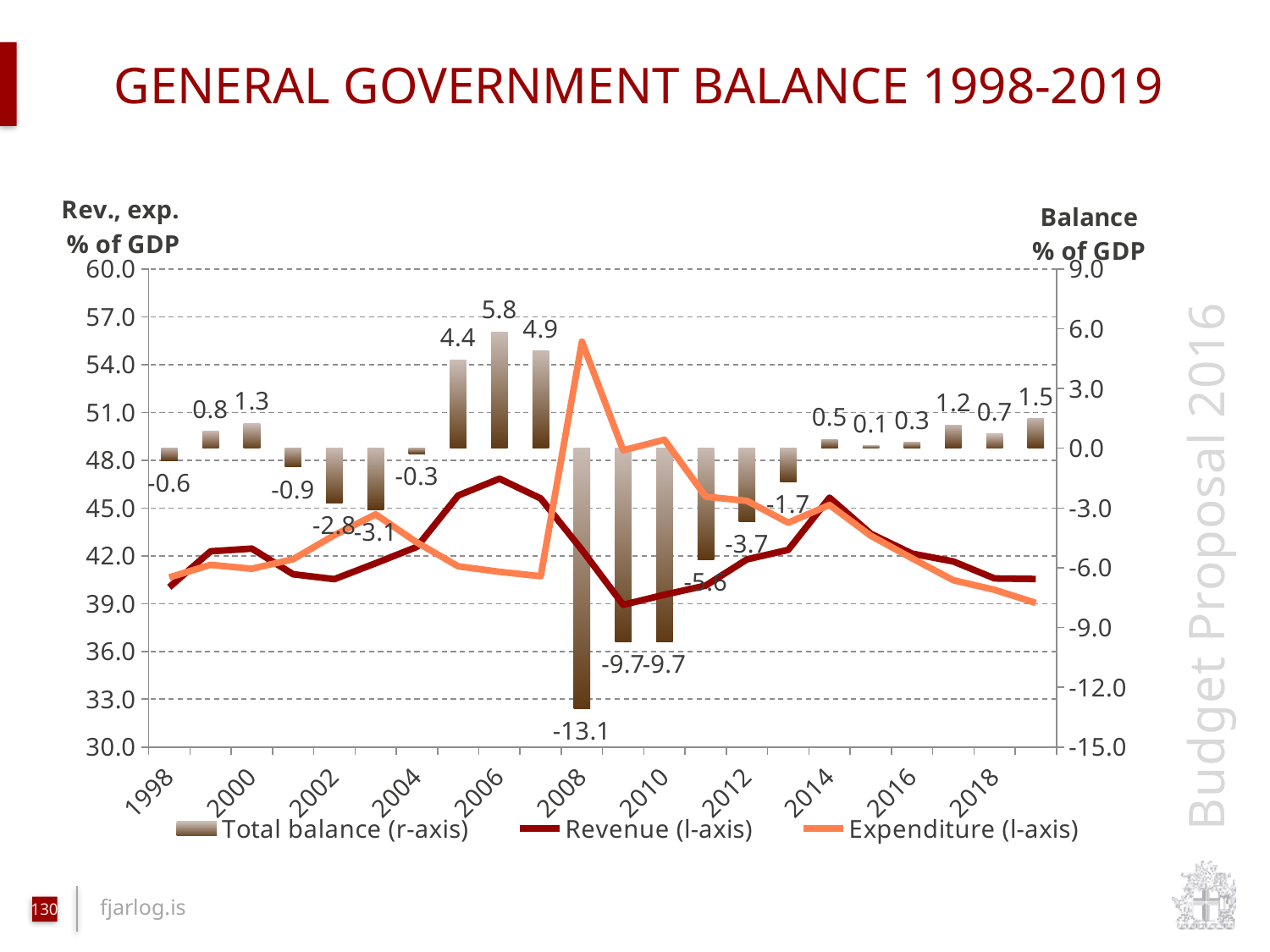
Does the total balance rise or fall from 2008 to 2014? Rise What kind of chart is shown on the slide? Combination bar and line chart Is the Expenditure value for 2008 greater or less than 54.0? greater In which year is the total balance bar lowest? 2008 What is the total balance value labelled for 2019? 1.5 Is the Revenue value for 2009 greater or less than 42.0? less How many years are plotted in the chart? 22 What is the difference between the total balance in 2006 (5.8) and in 2007 (4.9)? 0.9 How many series does the legend list? 3 What is the total balance (% of GDP) shown for 2008? -13.1 In which year is the total balance bar highest? 2006 Which year has the larger total balance, 2005 or 2007? 2007